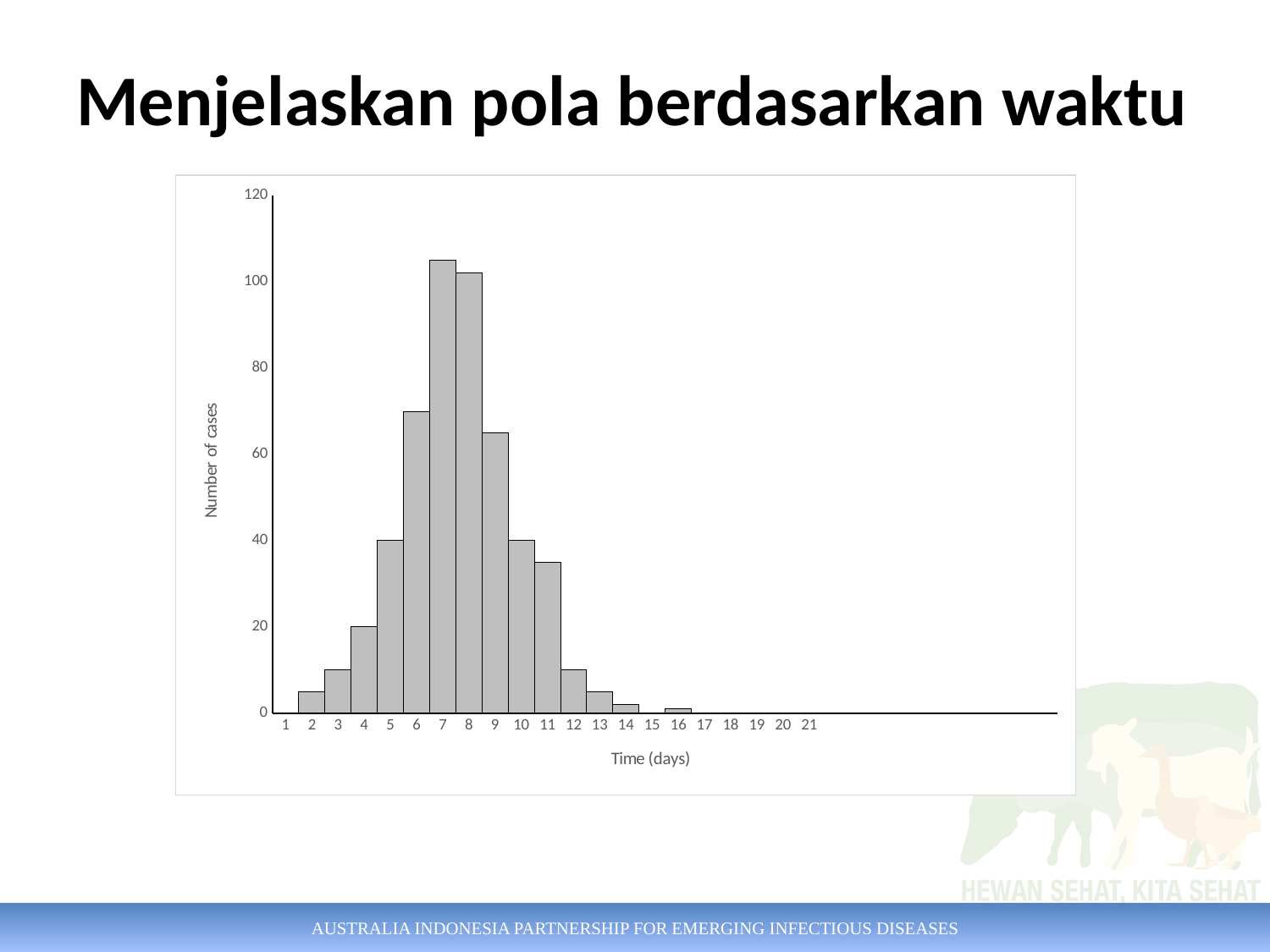
What is the title of the y axis? Number of cases Which has more cases, day 7 or day 9? day 7 What is the number of cases on day 5? 40 What is the number of cases on day 10? 40 What kind of chart is shown on the slide? bar chart How many days are labelled on the x axis? 21 Is the number of cases on day 7 greater or less than 100? greater Is the number of cases on day 3 greater or less than 20? less Do the number of cases rise or fall from day 8 to day 14? fall What is the number of cases on day 4? 20 Is the number of cases on day 6 greater or less than 60? greater